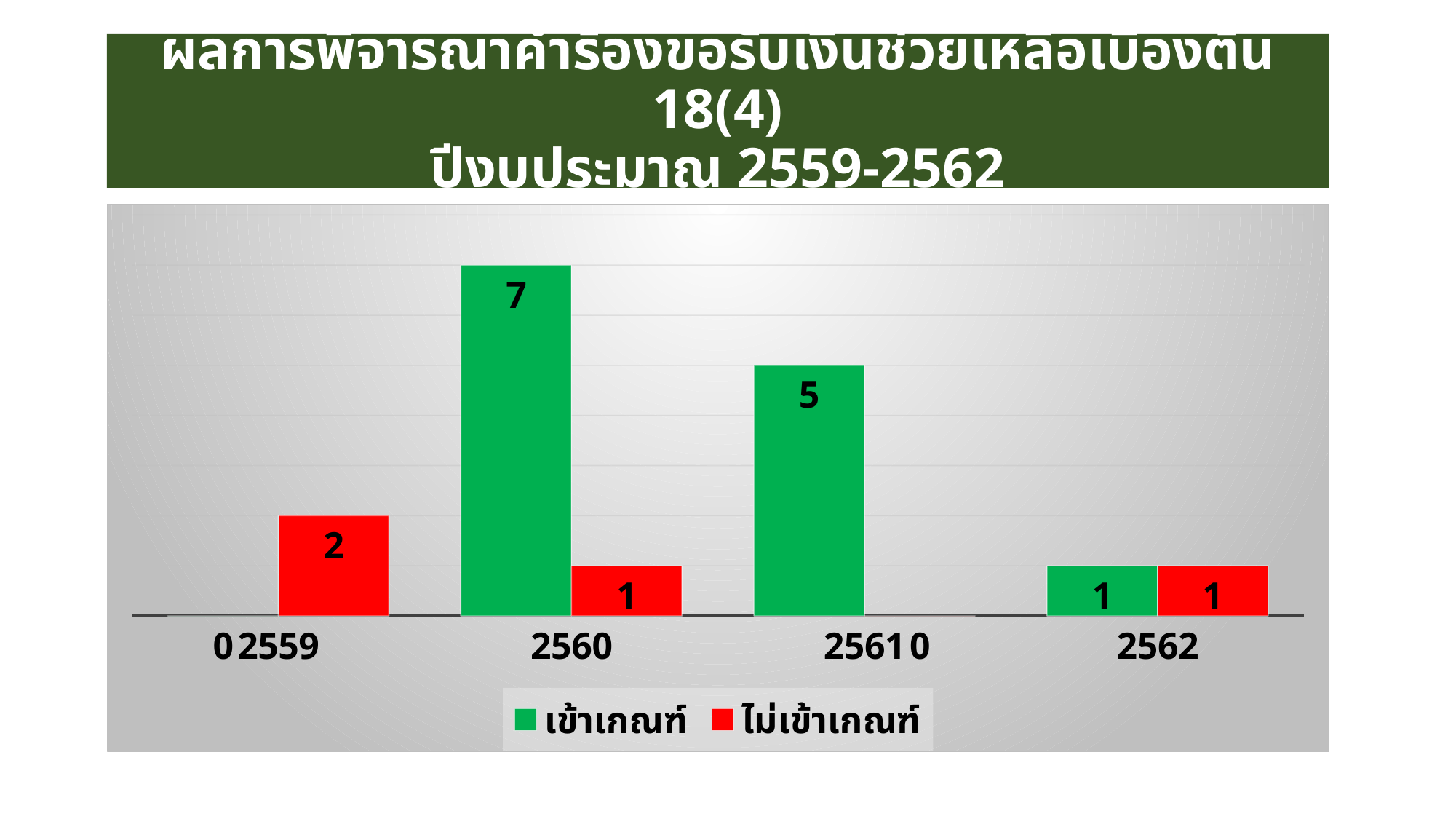
Which is larger for 2560: เข้าเกณฑ์ or ไม่เข้าเกณฑ์? เข้าเกณฑ์ What is the value of เข้าเกณฑ์ for 2561? 5 What is the value of ไม่เข้าเกณฑ์ for 2562? 1 How many series does the legend list? 2 Which year has the highest value for ไม่เข้าเกณฑ์? 2559 Which year has the highest value for เข้าเกณฑ์? 2560 What is the difference between the เข้าเกณฑ์ values for 2560 and 2561? 2 What is the value of เข้าเกณฑ์ for 2560? 7 What is the value of ไม่เข้าเกณฑ์ for 2559? 2 What colour represents ไม่เข้าเกณฑ์ in the legend? Red What kind of chart is shown on the slide? Bar chart How many years are shown on the x axis? 4